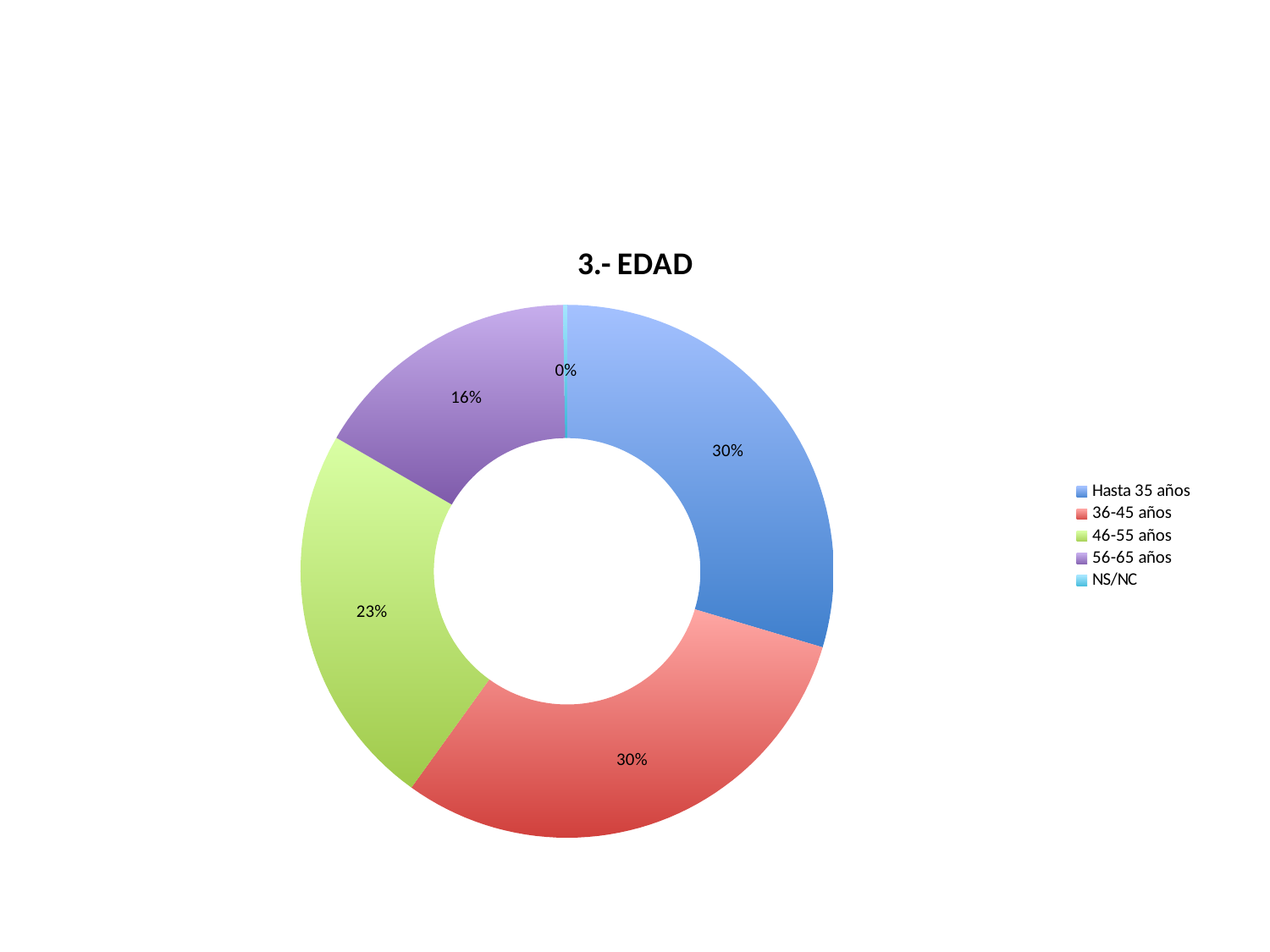
What percentage is shown for Hasta 35 años? 30% Which category has the smallest share? NS/NC Which colour represents 56-65 años in the chart? purple What kind of chart is shown on the slide? doughnut chart What is the title of the chart? 3.- EDAD What is the combined share of Hasta 35 años and 36-45 años? 60% What is the difference between the shares of 46-55 años and 56-65 años? 7% What percentage is shown for 56-65 años? 16% Which is larger, the share for 36-45 años or the share for 46-55 años? 36-45 años What percentage is shown for NS/NC? 0% What percentage is shown for 46-55 años? 23% How many categories does the legend list? 5